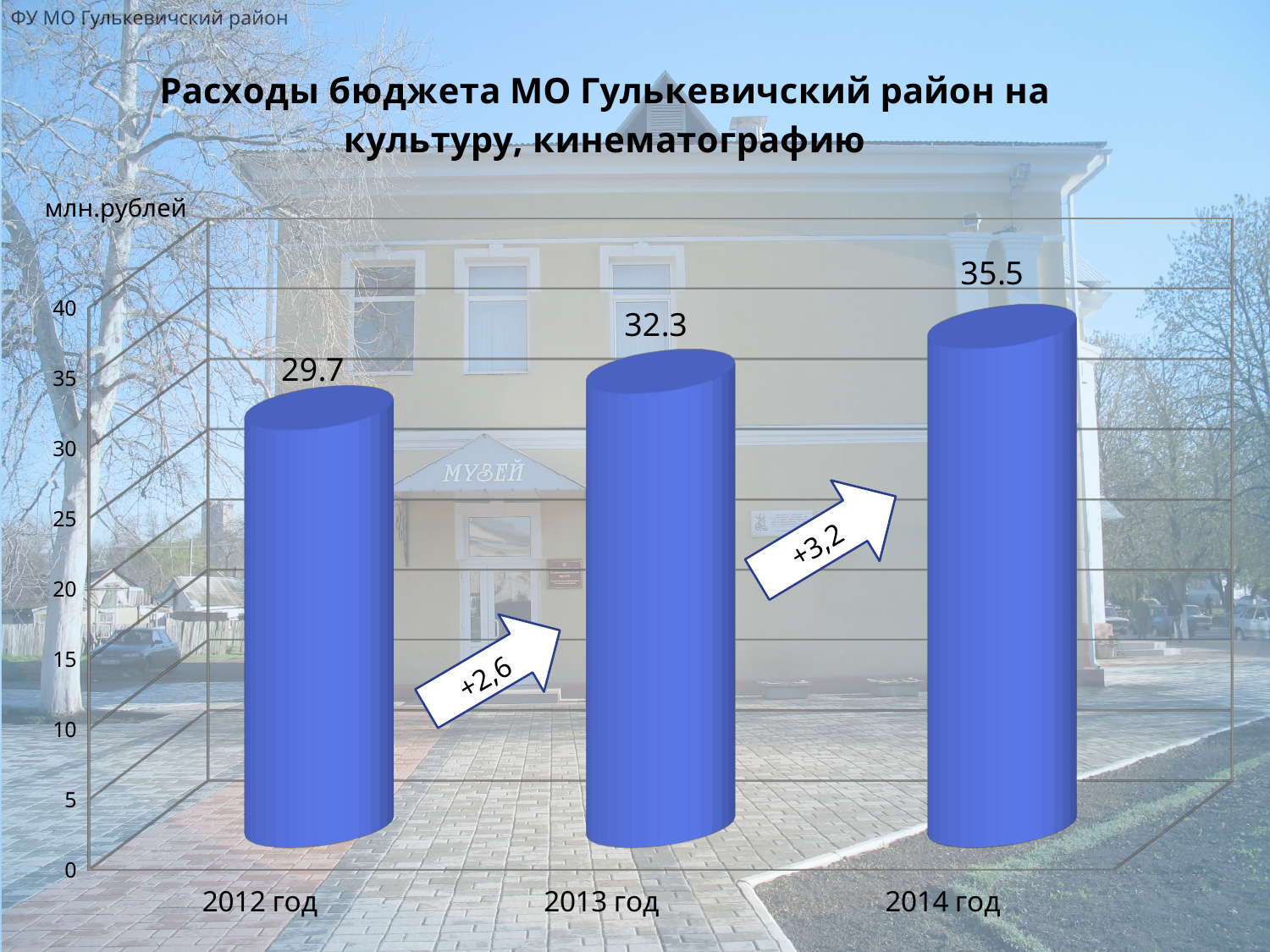
What is the difference between the values for 2014 год and 2012 год? 5.8 What kind of chart is shown on the slide? bar chart Which is larger, the value for 2013 год or the value for 2014 год? 2014 год What is the difference between the values for 2013 год and 2012 год? 2.6 Which year has the lowest value? 2012 год Which year has the highest value? 2014 год What is the value for 2014 год? 35.5 Do the values rise or fall from 2012 год to 2014 год? rise What is the value for 2013 год? 32.3 How many years are shown on the chart? 3 Is the value for 2012 год greater or less than 30? less What is the value for 2012 год? 29.7